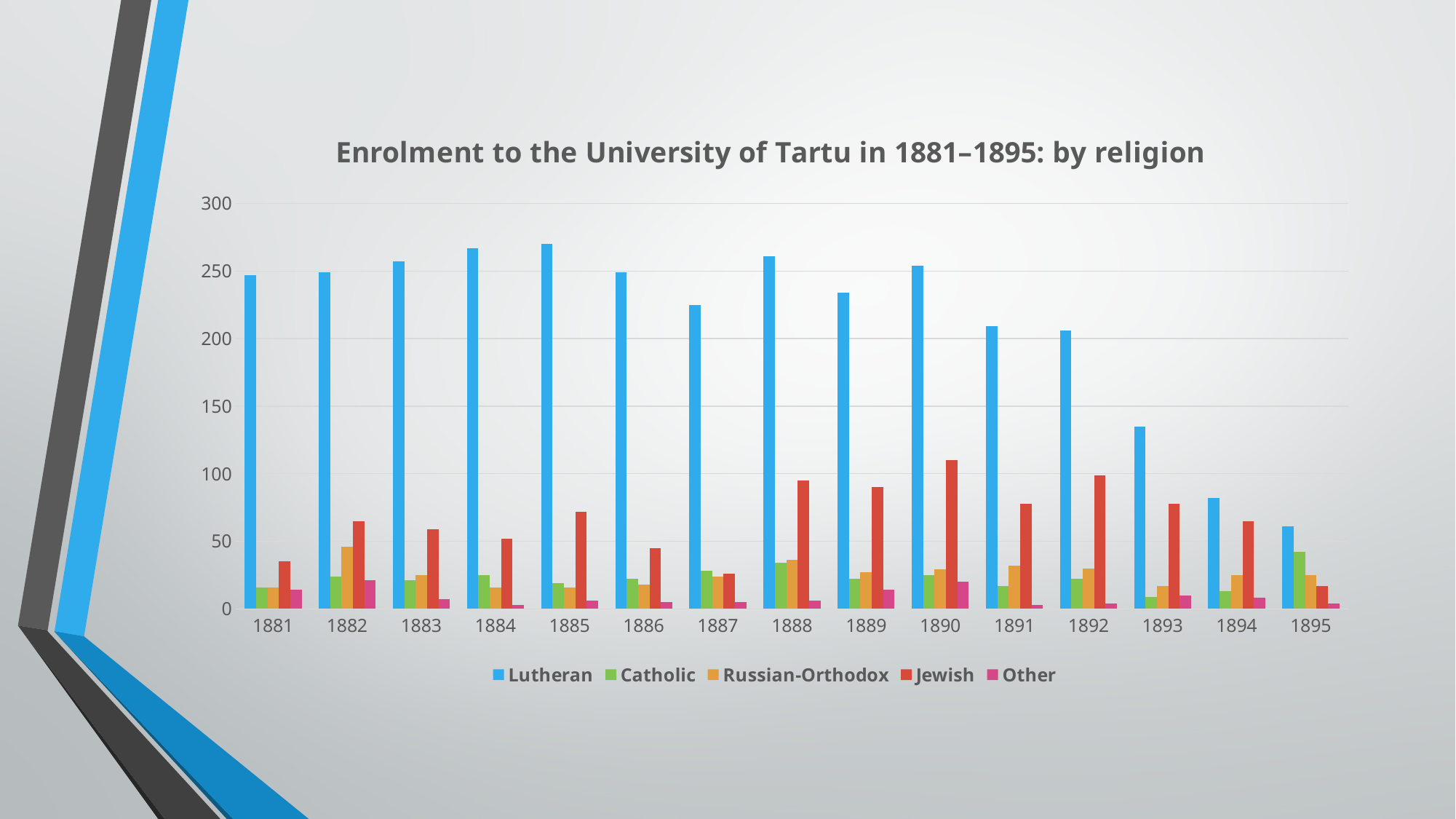
Is the Lutheran value for 1895 greater or less than 50? greater Which is larger, the Lutheran enrolment in 1881 or in 1895? 1881 Is the Lutheran value for 1887 greater or less than 250? less In which year is the Jewish enrolment highest? 1890 How many series does the legend list? 5 In which year is the Lutheran enrolment lowest? 1895 Does the Lutheran enrolment rise or fall from 1890 to 1895? fall What kind of chart is shown on the slide? bar chart How many years are shown on the x axis? 15 In 1890, which is larger, the Jewish enrolment or the Catholic enrolment? Jewish What is the title of the chart? Enrolment to the University of Tartu in 1881–1895: by religion Is the Lutheran value for 1893 greater or less than 100? greater